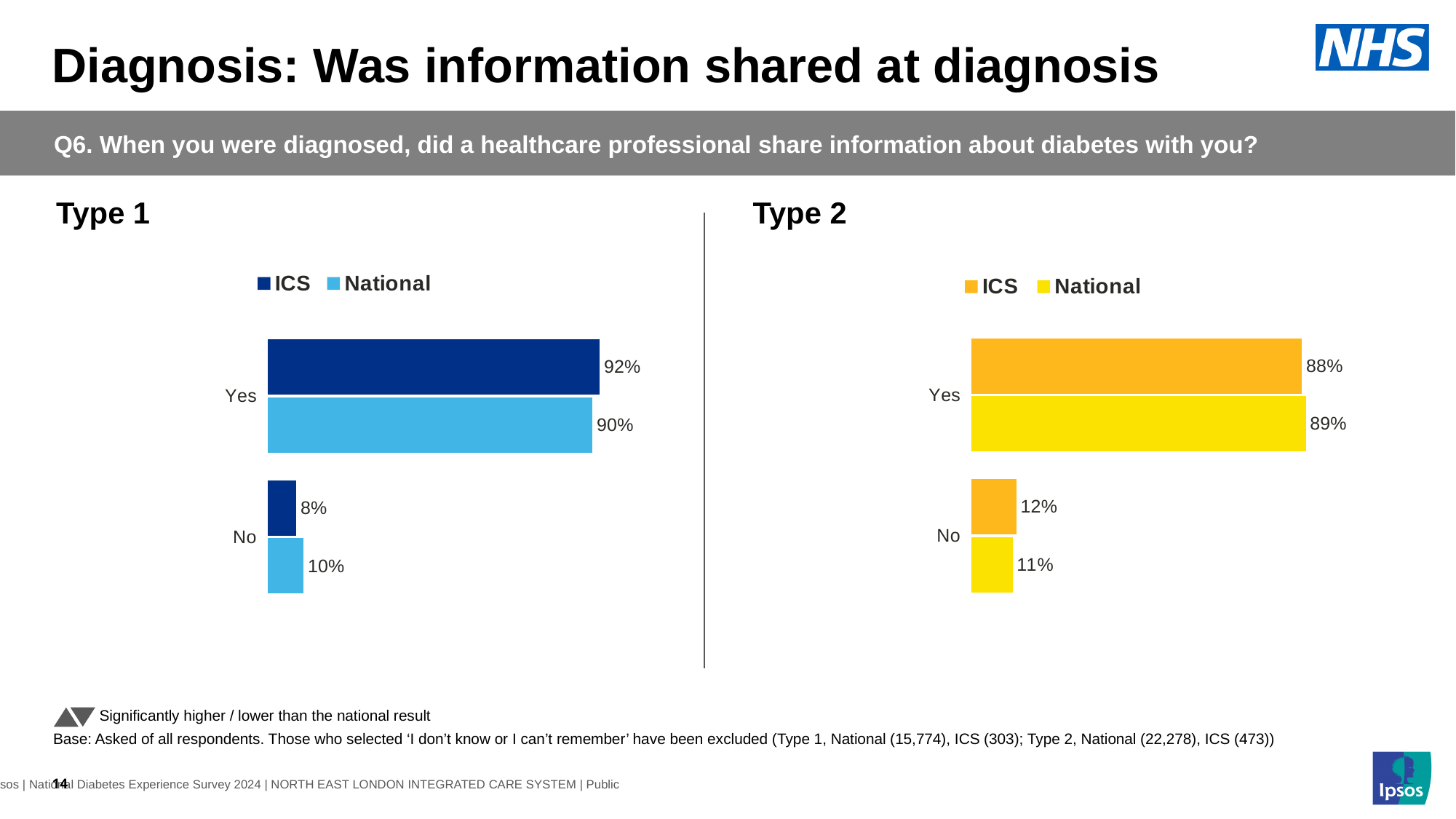
In the Type 2 chart, what is the difference between the ICS and National values for No? 1 percentage point In the Type 2 chart, which is larger for Yes, ICS or National? National What kind of chart is the Type 2 chart? Bar chart In the Type 1 chart, what is the ICS value for Yes? 92% How many categories are shown in the Type 1 chart? 2 In the Type 1 chart, which is larger for No, ICS or National? National In the Type 1 chart, what is the National value for No? 10% In the Type 2 chart, what is the ICS value for Yes? 88% In the Type 1 chart, what is the difference between the ICS and National values for Yes? 2 percentage points In the Type 1 chart, which category has the highest ICS value? Yes How many series does the legend of the Type 2 chart list? 2 In the Type 2 chart, what is the National value for No? 11%